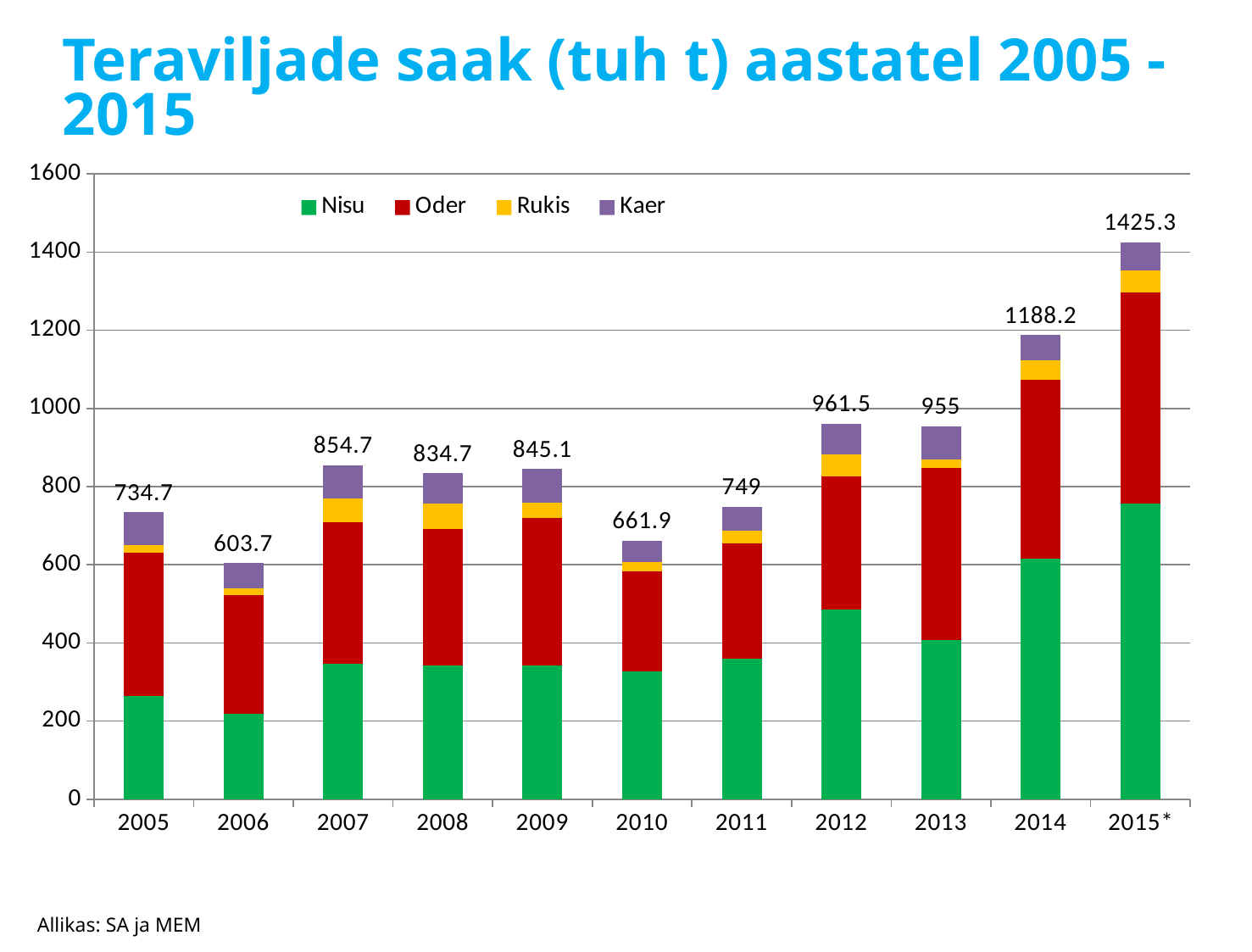
What is the total value labelled above the bar for 2010? 661.9 How many series does the legend list? 4 Which year has the lowest total cereal yield? 2006 Is the Nisu value for 2015* greater or less than 600? greater How many years are shown on the x axis? 11 What is the difference between the total for 2015* and the total for 2014? 237.1 What kind of chart is shown on the slide? Stacked bar chart Which series is shown in green in the legend? Nisu Is the Nisu value for 2006 greater or less than 400? less Which year has the highest total cereal yield? 2015* What is the total cereal yield shown for 2015*? 1425.3 Which year has the larger total, 2012 or 2013? 2012